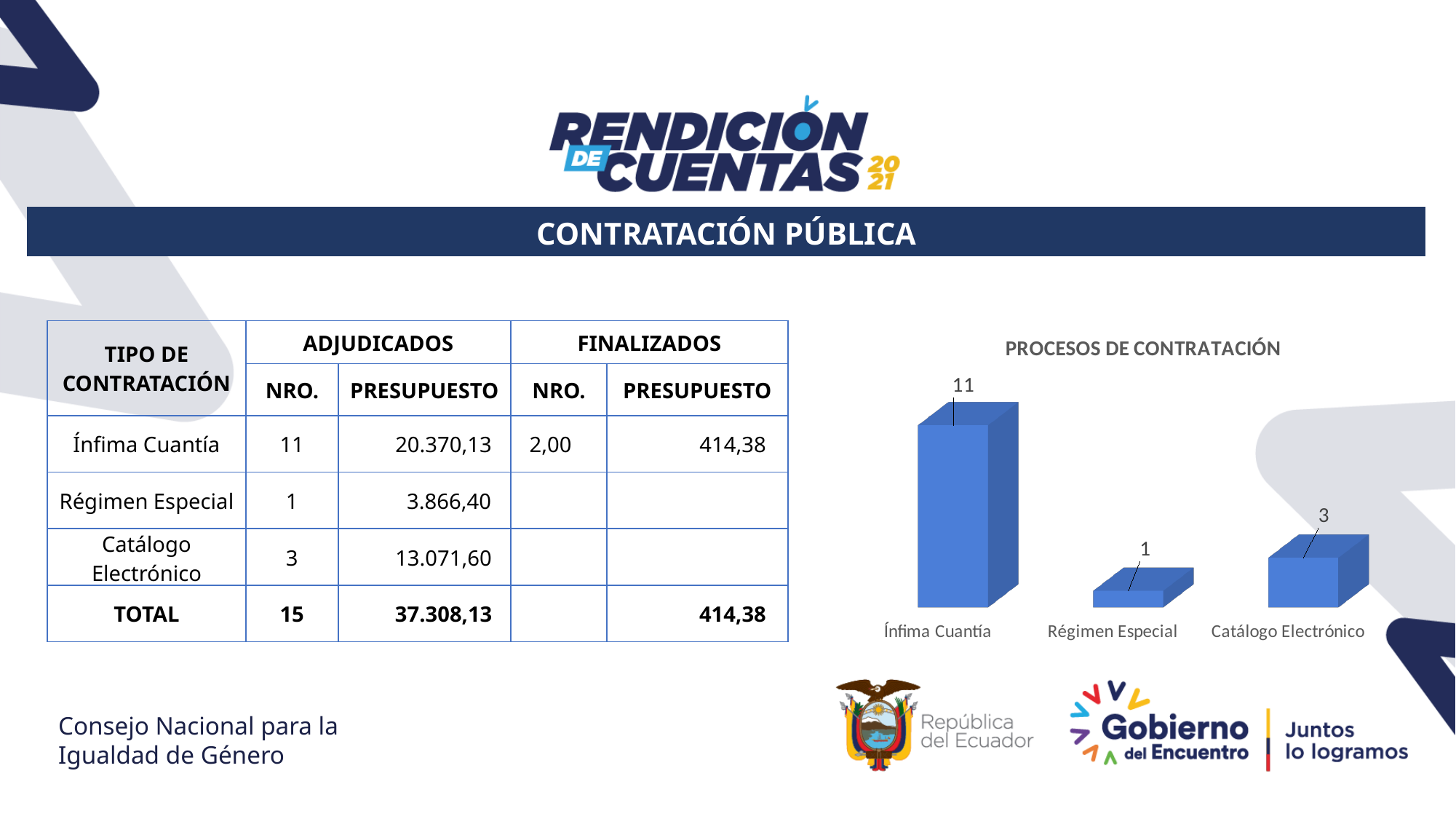
How many categories are shown in the PROCESOS DE CONTRATACIÓN chart? 3 Which category has the highest value in the PROCESOS DE CONTRATACIÓN chart? Ínfima Cuantía Which category has the lowest value in the PROCESOS DE CONTRATACIÓN chart? Régimen Especial What is the sum of all three values shown in the PROCESOS DE CONTRATACIÓN chart? 15 In the PROCESOS DE CONTRATACIÓN chart, which is larger: Régimen Especial or Catálogo Electrónico? Catálogo Electrónico What kind of chart is the PROCESOS DE CONTRATACIÓN chart? Bar chart What is the value for Ínfima Cuantía in the PROCESOS DE CONTRATACIÓN chart? 11 What is the title of the chart on the slide? PROCESOS DE CONTRATACIÓN What is the value for Régimen Especial in the PROCESOS DE CONTRATACIÓN chart? 1 What is the difference between the values for Catálogo Electrónico and Régimen Especial in the PROCESOS DE CONTRATACIÓN chart? 2 What is the difference between the values for Ínfima Cuantía and Catálogo Electrónico in the PROCESOS DE CONTRATACIÓN chart? 8 What is the value for Catálogo Electrónico in the PROCESOS DE CONTRATACIÓN chart? 3